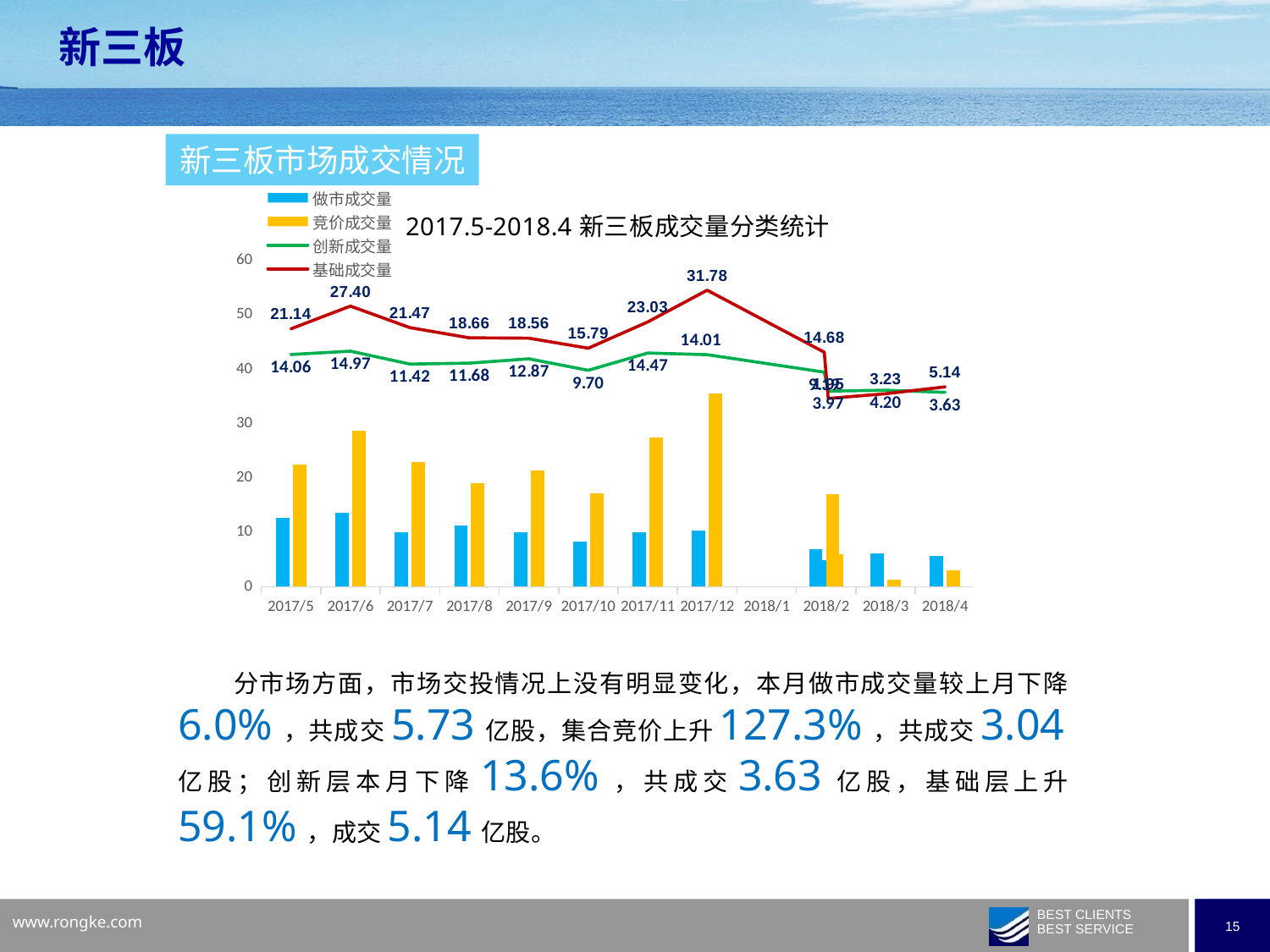
What is the value of 基础成交量 for 2018/4? 5.14 How many months are shown on the x axis? 12 Which is larger, 基础成交量 in 2017/6 or in 2017/7? 2017/6 In which month is 创新成交量 at its lowest labelled value? 2018/4 How many series does the legend list? 4 Is the 竞价成交量 bar for 2017/12 greater or less than 30? greater In which month does 基础成交量 reach its highest value? 2017/12 What is the value of 创新成交量 for 2017/10? 9.70 What is the value of 基础成交量 for 2017/12? 31.78 Is the 竞价成交量 bar for 2018/3 greater or less than 10? less What kind of chart is this? Combined bar and line chart What is the difference between 基础成交量 in 2017/12 and 2017/11? 8.75